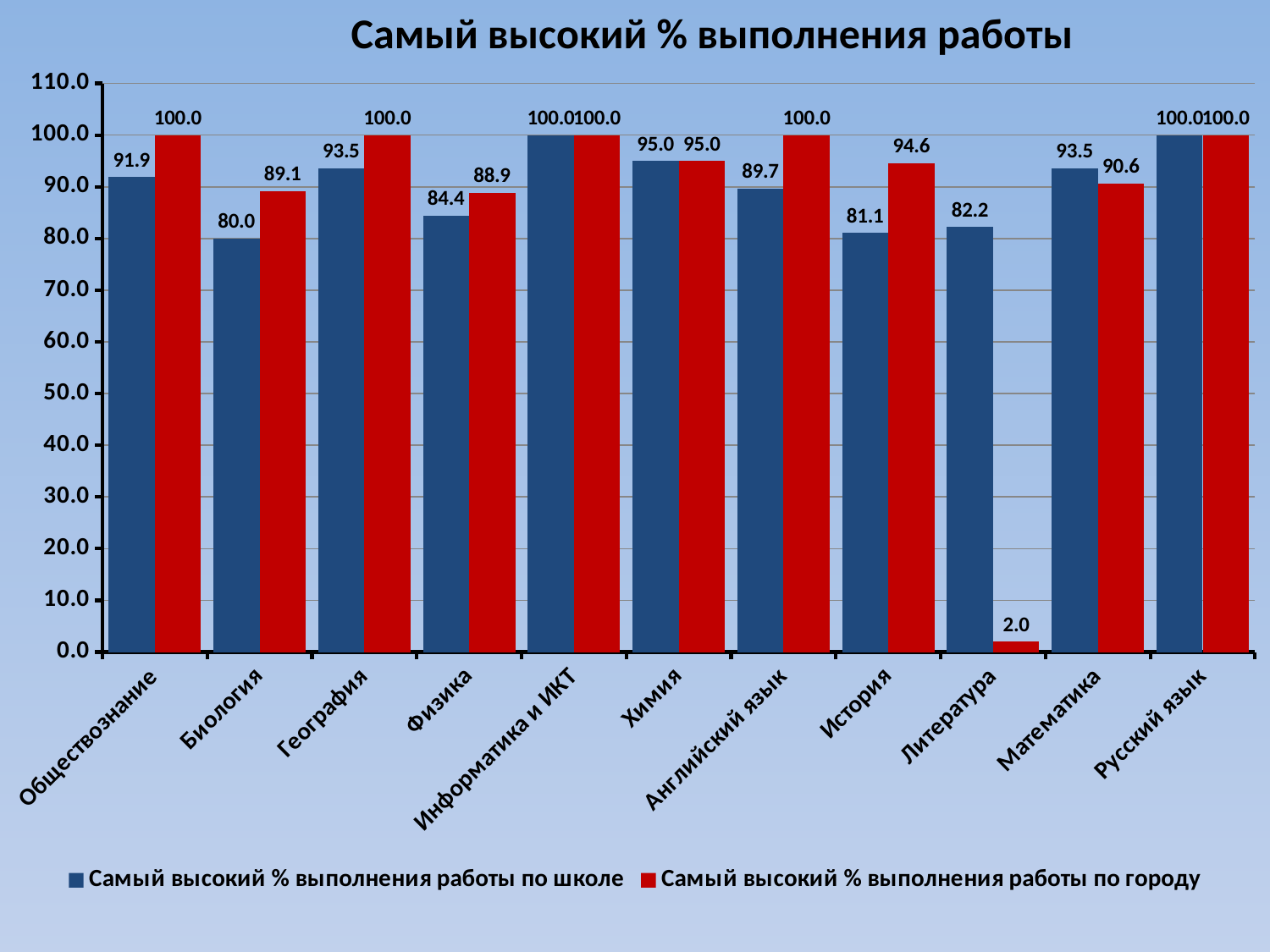
How many subjects are shown on the x axis? 11 For Обществознание, what is the difference between the 'по городу' value and the 'по школе' value? 8.1 Which subject has the lowest value for 'Самый высокий % выполнения работы по городу'? Литература Which subject has the lowest value for 'Самый высокий % выполнения работы по школе'? Биология What is the value of 'Самый высокий % выполнения работы по городу' for История? 94.6 How many series does the legend list? 2 What is the value of 'Самый высокий % выполнения работы по городу' for Литература? 2.0 For Математика, which is larger: the 'по школе' value or the 'по городу' value? по школе For История, how much higher is the 'по городу' value than the 'по школе' value? 13.5 What kind of chart is shown on the slide? Bar chart What is the value of 'Самый высокий % выполнения работы по школе' for Биология? 80.0 What is the value of 'Самый высокий % выполнения работы по школе' for Физика? 84.4